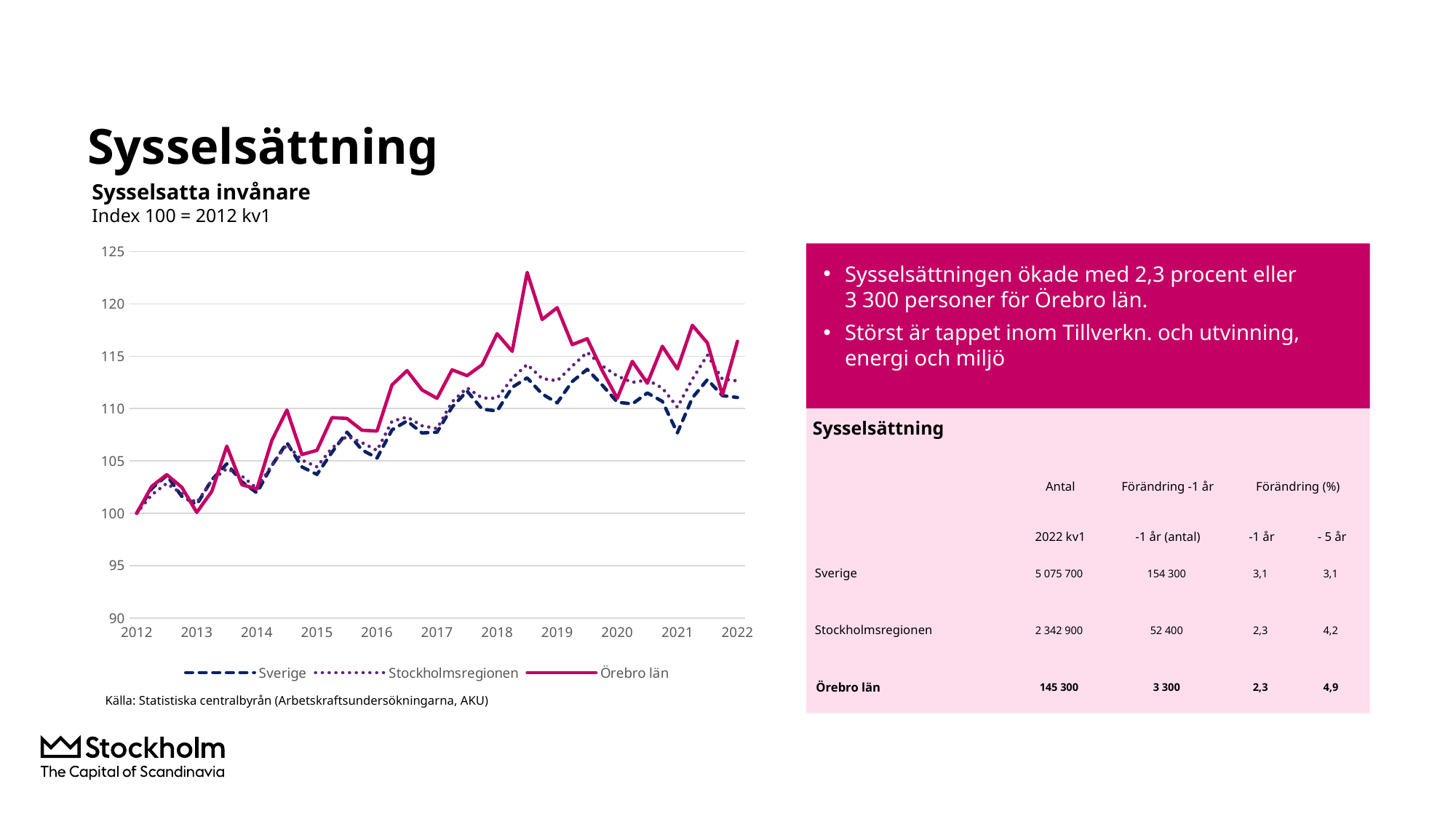
At the end of the chart in 2022, which series is higher: Örebro län or Sverige? Örebro län How many series does the chart legend list? 3 What is the title of the chart? Sysselsatta invånare How many year labels are shown on the x axis? 11 What index value do all three series have at 2012 kv1? 100 What kind of chart is shown on the slide? line chart Is the peak value for Örebro län in 2018 greater or less than 120? greater Do the index values generally rise or fall from 2012 to 2022? rise Is the final 2022 value for Örebro län greater or less than 115? greater Is the lowest value for Sverige in 2021 greater or less than 110? less Which series is drawn as a solid line in the chart? Örebro län Which series reaches the highest index value at any point in the chart? Örebro län